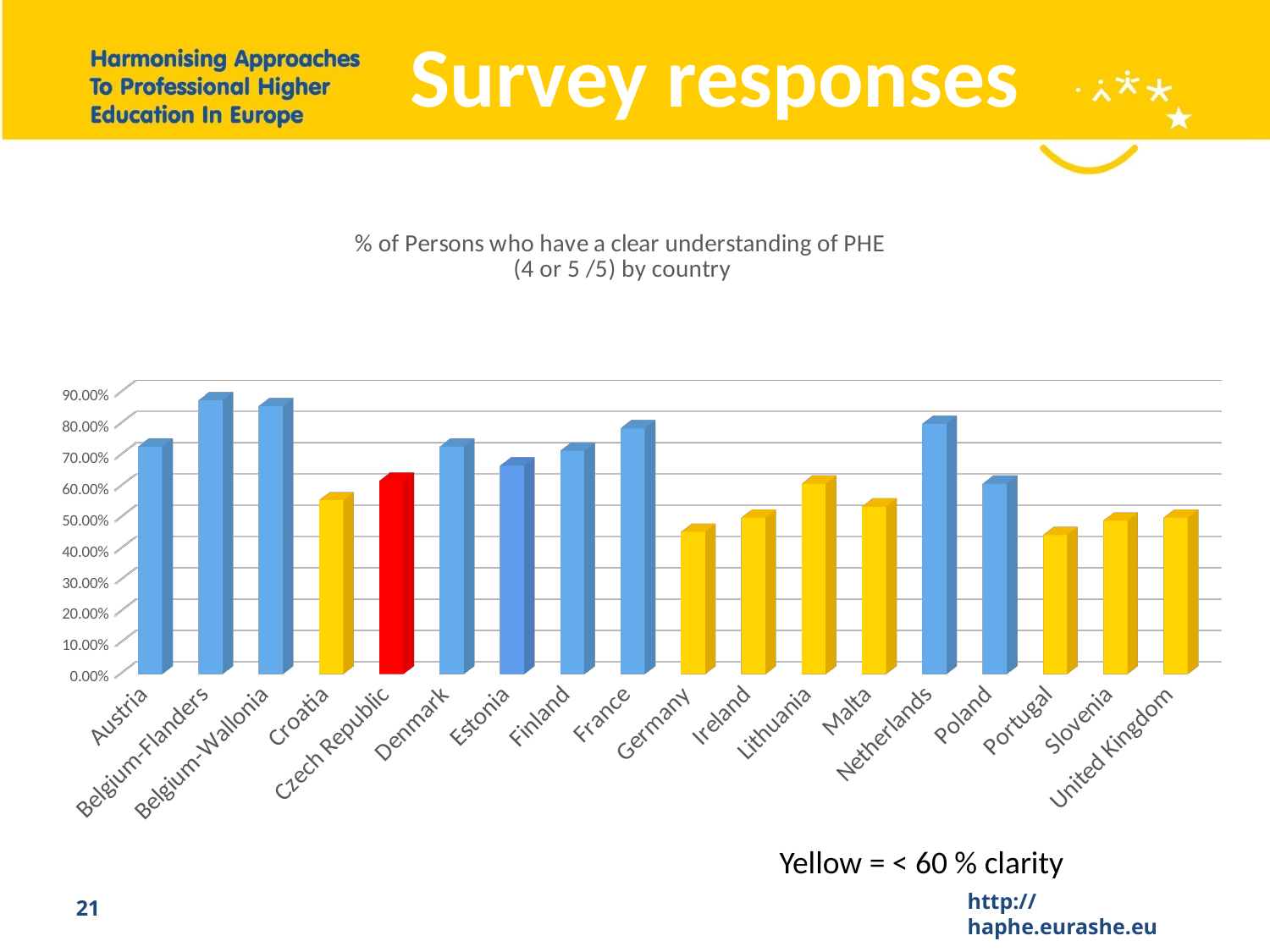
Is the value for Belgium-Flanders greater or less than 80.00%? greater What is the title of the chart? % of Persons who have a clear understanding of PHE (4 or 5 /5) by country Which country's bar is coloured red in the chart? Czech Republic Is the value for Netherlands greater or less than 70.00%? greater Is the value for France greater or less than 70.00%? greater How many countries are shown on the x axis of the chart? 18 Which has a higher value, Belgium-Wallonia or Croatia? Belgium-Wallonia Which has a higher value, Netherlands or Poland? Netherlands Which country has the highest percentage of persons with a clear understanding of PHE? Belgium-Flanders What kind of chart is shown on the slide? bar chart